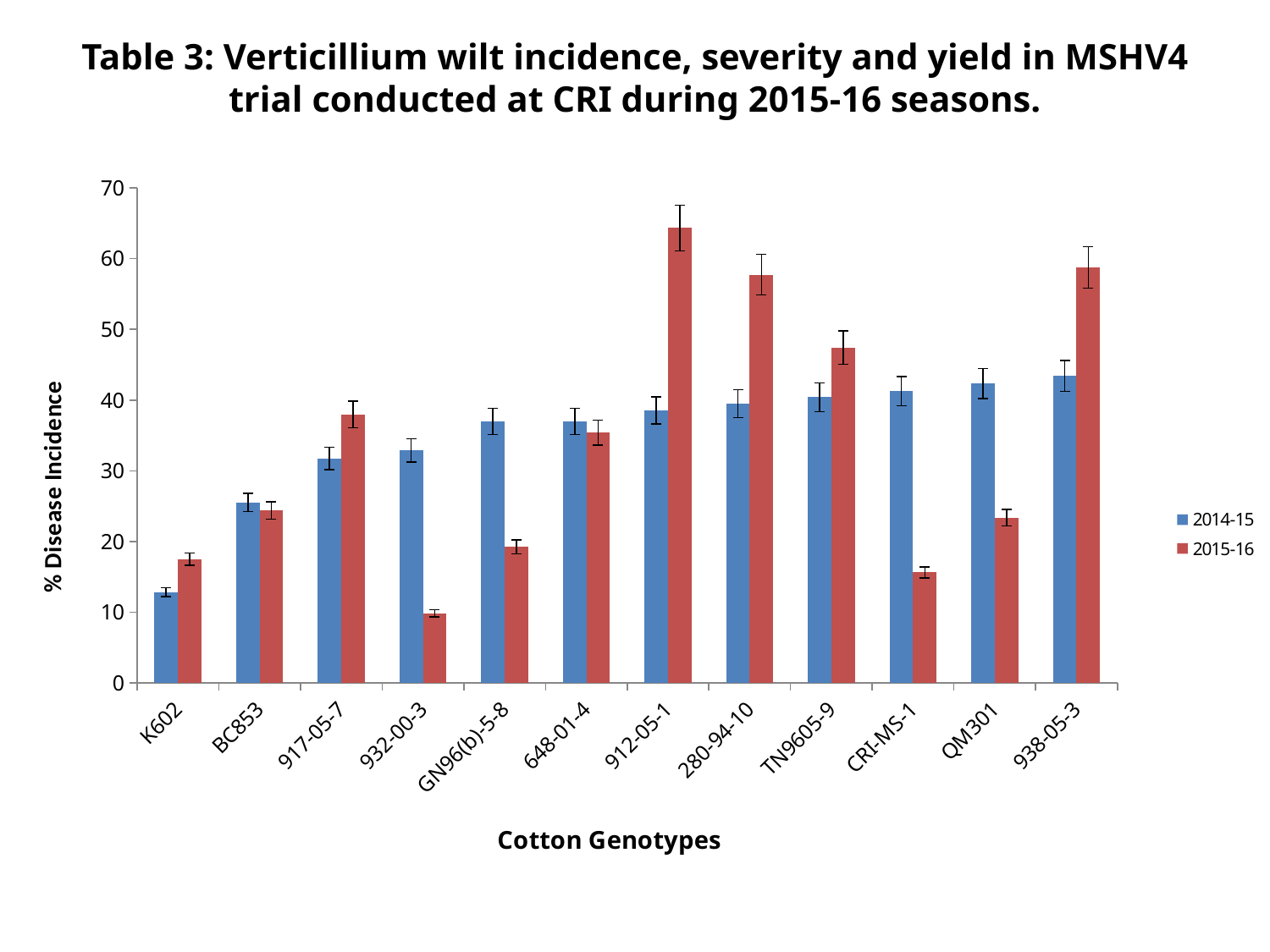
How many series does the legend list? 2 Is the 2015-16 value for 912-05-1 greater or less than 60? greater Is the 2015-16 value for 280-94-10 greater or less than 50? greater For GN96(b)-5-8, which series has the larger % disease incidence, 2014-15 or 2015-16? 2014-15 What kind of chart is shown on the slide? bar chart What is the label of the y axis? % Disease Incidence Which genotype has the highest % disease incidence in the 2015-16 series? 912-05-1 Which genotype has the lowest % disease incidence in the 2015-16 series? 932-00-3 Is the 2014-15 value for K602 greater or less than 20? less For K602, which series has the larger % disease incidence, 2014-15 or 2015-16? 2015-16 How many cotton genotypes are shown on the x axis? 12 Which genotype has the lowest % disease incidence in the 2014-15 series? K602